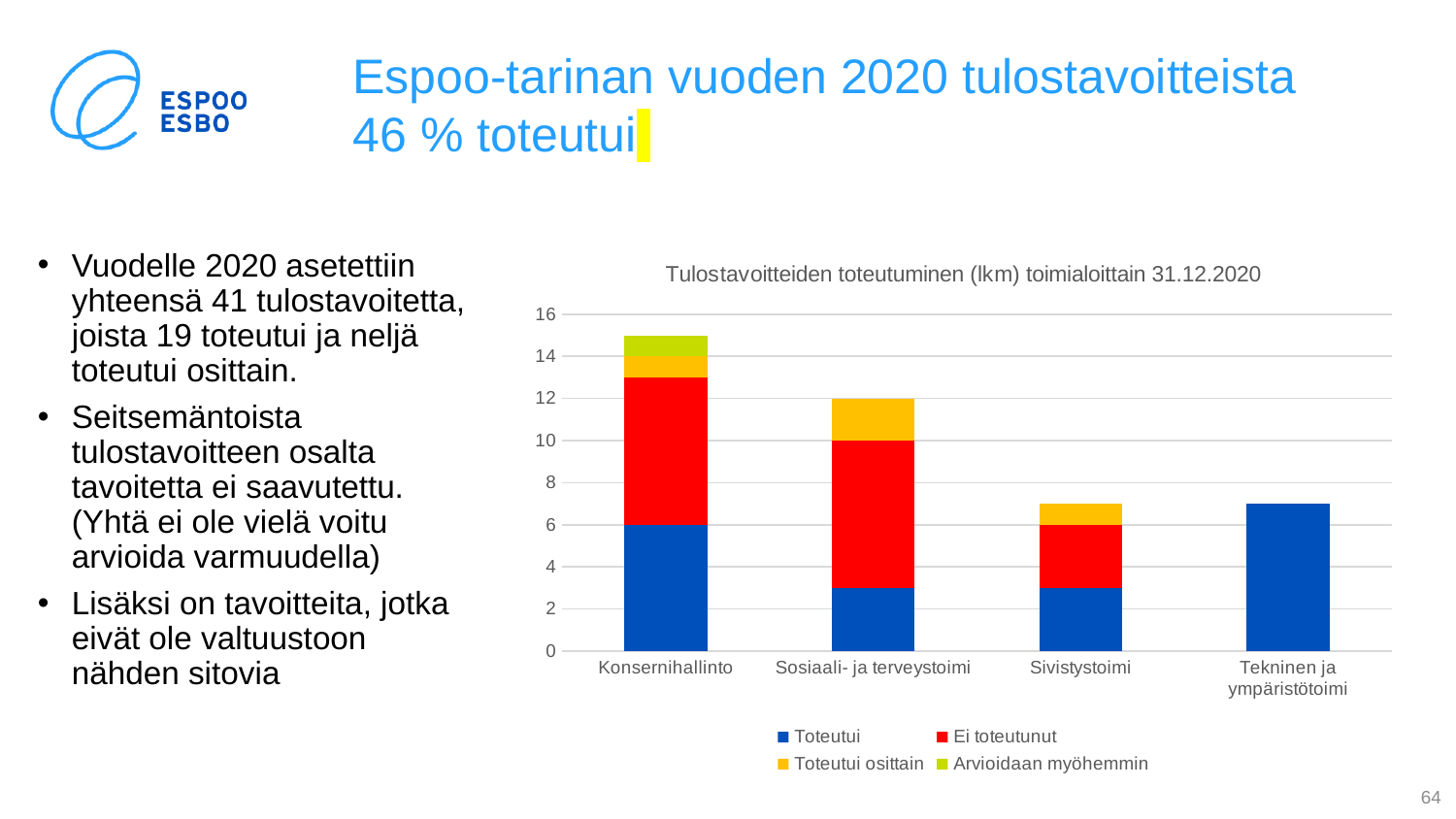
How many series does the chart legend list? 4 What is the title of the chart? Tulostavoitteiden toteutuminen (lkm) toimialoittain 31.12.2020 Is the total for Konsernihallinto greater or less than 14? greater What is the Toteutui value for Konsernihallinto? 6 What is the total height of the stacked bar for Sosiaali- ja terveystoimi? 12 How many categories (toimialat) are shown on the x axis of the chart? 4 What kind of chart is shown on the slide? Stacked bar chart Which category has the tallest stacked bar in the chart? Konsernihallinto Is the total for Sivistystoimi greater or less than 6? greater Which series is shown in red in the chart? Ei toteutunut Is the total for Tekninen ja ympäristötoimi greater or less than 8? less Which has the larger total, Konsernihallinto or Sosiaali- ja terveystoimi? Konsernihallinto